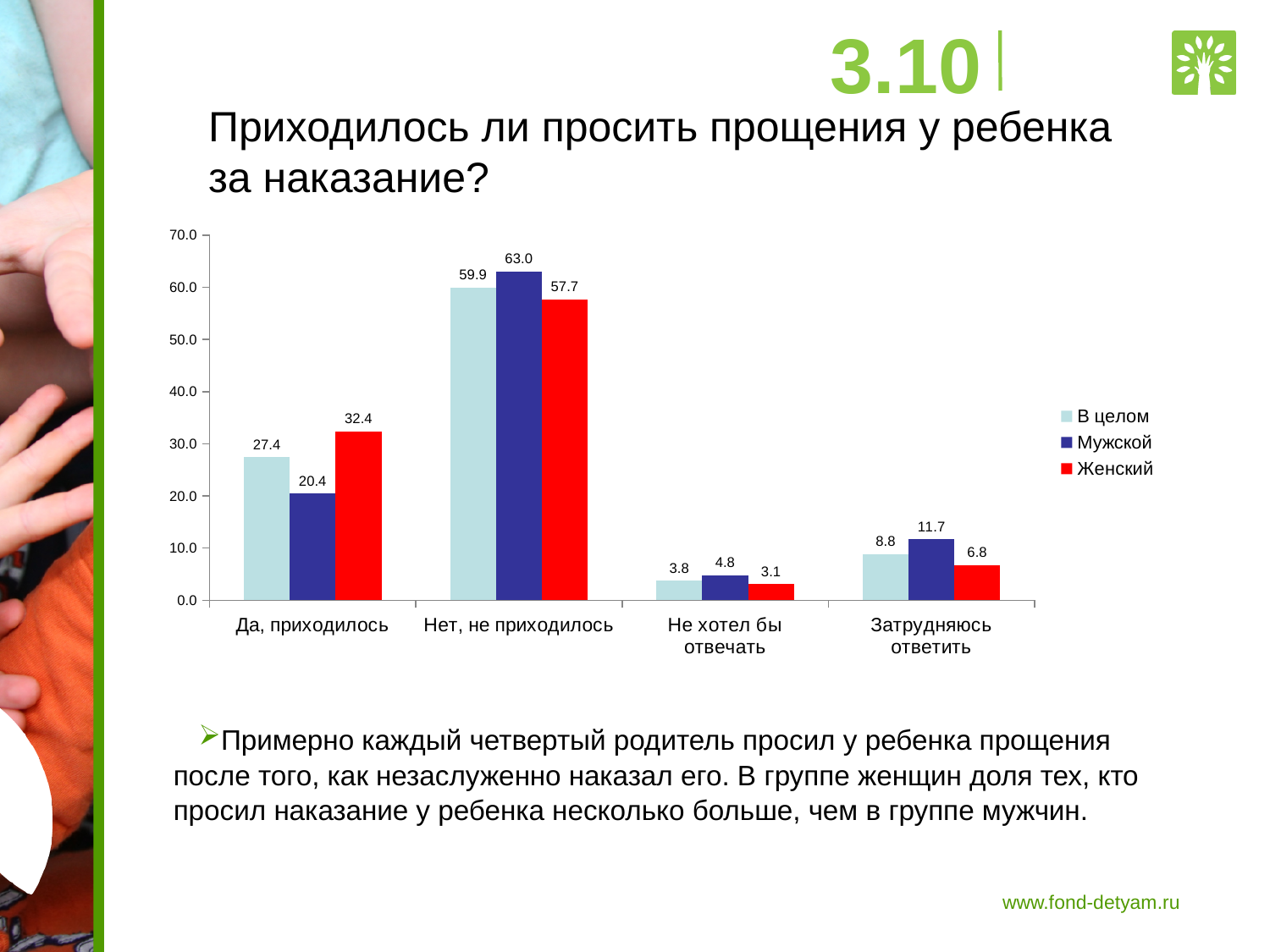
In the "Нет, не приходилось" category, which is larger: the "Мужской" value or the "Женский" value? Мужской What kind of chart is shown on the slide? bar chart Which category has the lowest value for the "Женский" series? Не хотел бы отвечать How many categories are shown on the x axis? 4 What is the difference between the "Женский" and "Мужской" values in the "Да, приходилось" category? 12.0 What is the value for "В целом" in the "Затрудняюсь ответить" category? 8.8 Which colour represents the "Женский" series in the chart? red How many series does the legend list? 3 Which category has the highest value for the "В целом" series? Нет, не приходилось What is the value for "Женский" in the "Нет, не приходилось" category? 57.7 Is the value for "В целом" in the "Да, приходилось" category greater or less than 30.0? less What is the value for "Мужской" in the "Да, приходилось" category? 20.4